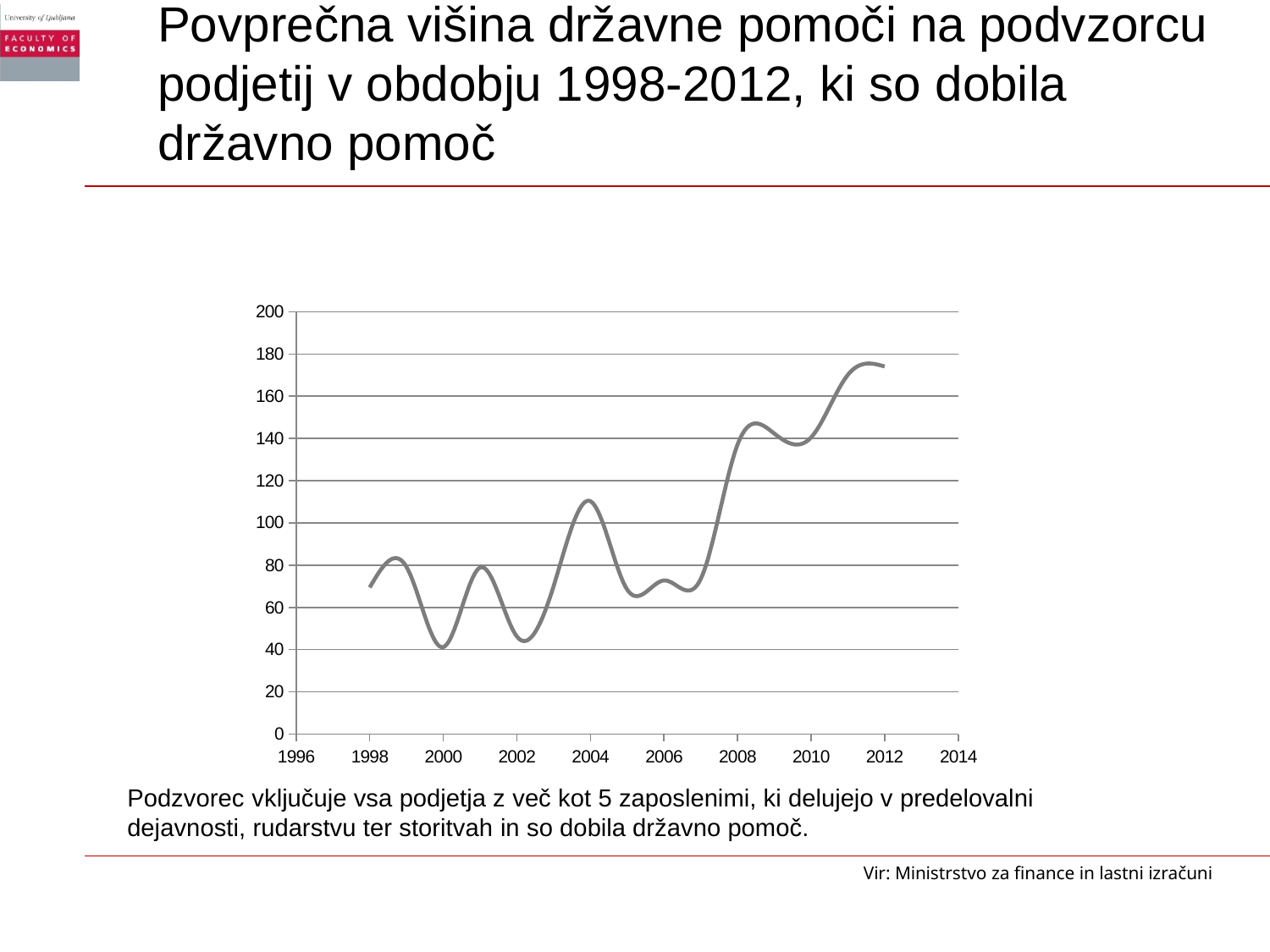
Is the value for 2008 greater or less than 120? greater What is the highest value shown on the vertical axis? 200 Which year has the larger value, 2000 or 2004? 2004 Which year has the larger value, 2004 or 2006? 2004 Is the value for 2000 greater or less than 60? less What kind of chart is shown on the slide? line chart Is the value for 2006 greater or less than 80? less What source is cited at the bottom of the slide? Ministrstvo za finance in lastni izračuni Which year has the larger value, 1998 or 2012? 2012 Overall, do the values rise or fall from 1998 to 2012? rise